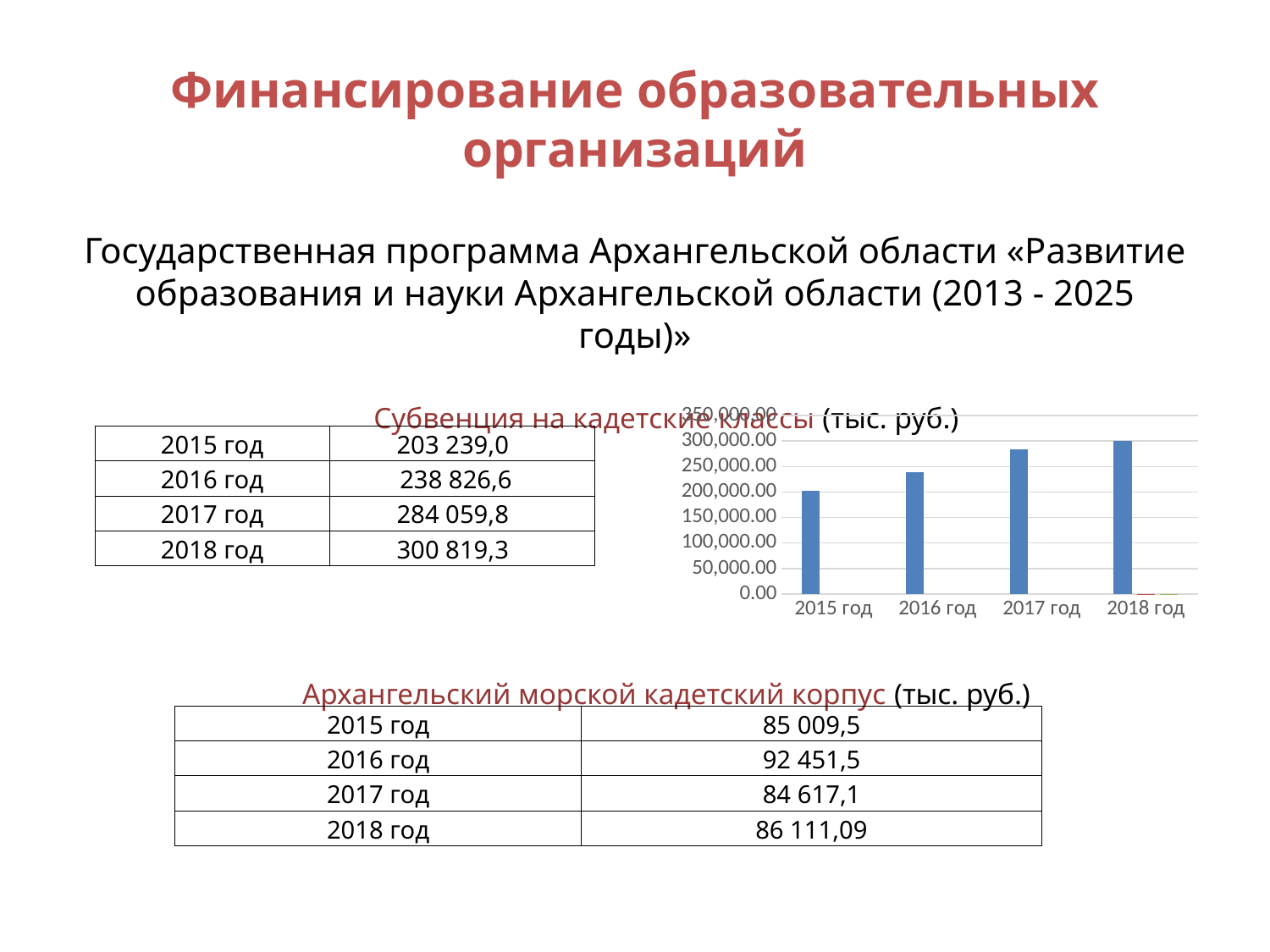
Is the bar for 2016 год greater or less than 250,000.00? less Which year has the shortest bar in the chart? 2015 год Is the bar for 2018 год greater or less than 250,000.00? greater Is the bar for 2015 год greater or less than 250,000.00? less How many years are shown on the x axis of the bar chart? 4 According to the table beside the chart, what is the value for 2017 год? 284 059,8 Using the values in the table beside the chart, what is the difference between 2018 год and 2015 год? 97 580,3 Which bar is taller, 2016 год or 2017 год? 2017 год Which year has the tallest bar in the chart? 2018 год What kind of chart is shown on the slide? bar chart Do the bar values rise or fall from 2015 год to 2018 год? rise